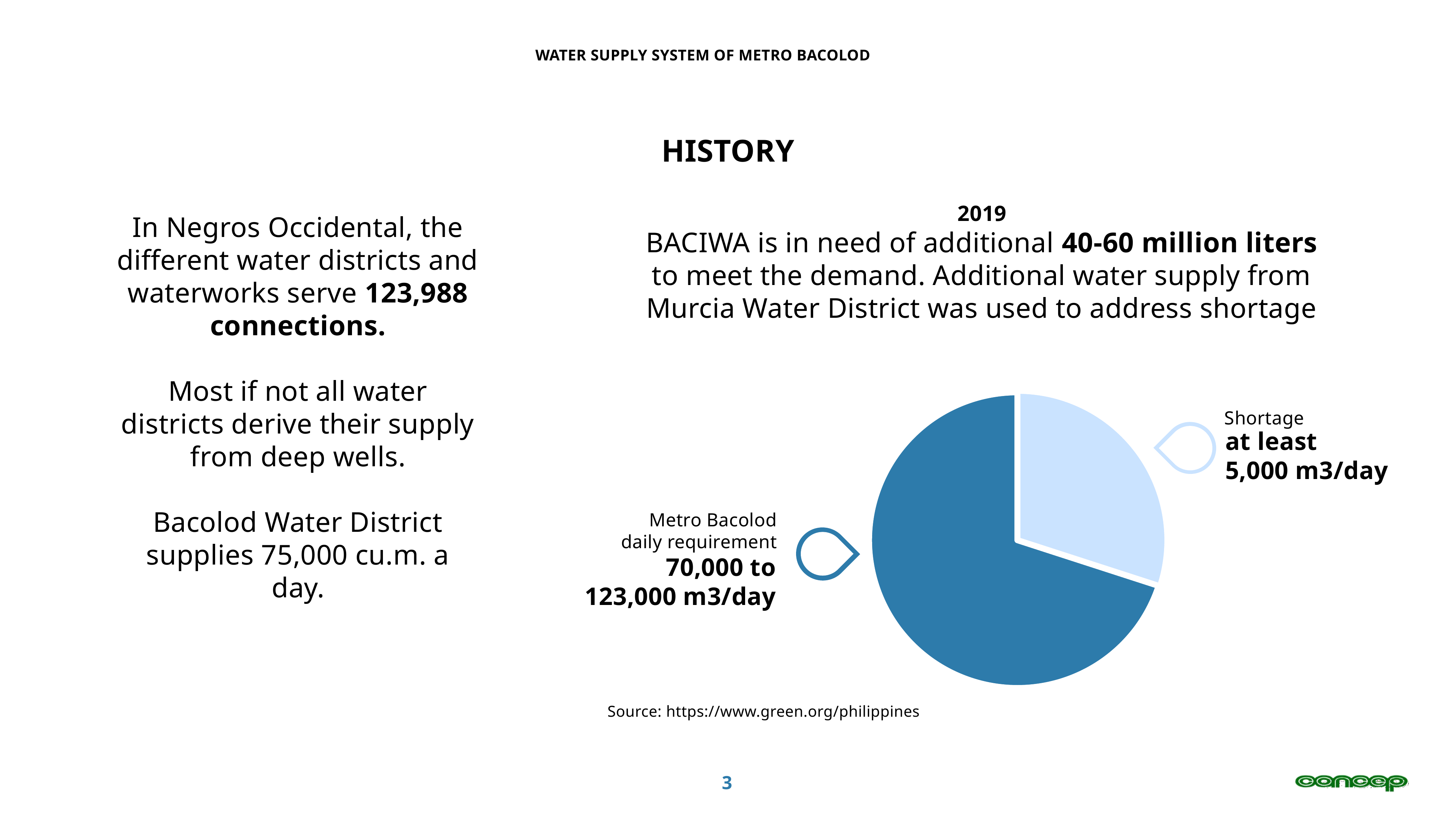
How many slices does the pie chart have? 2 What value is printed for the Metro Bacolod daily requirement slice of the pie chart? 70,000 to 123,000 m3/day Which slice of the pie chart is the largest? Metro Bacolod daily requirement What value is printed for the Shortage slice of the pie chart? at least 5,000 m3/day Which slice is larger in the pie chart, Metro Bacolod daily requirement or Shortage? Metro Bacolod daily requirement What source is cited below the pie chart? https://www.green.org/philippines What kind of chart is shown on the slide? pie chart What colour is the Shortage slice of the pie chart? light blue Which slice of the pie chart is the smallest? Shortage